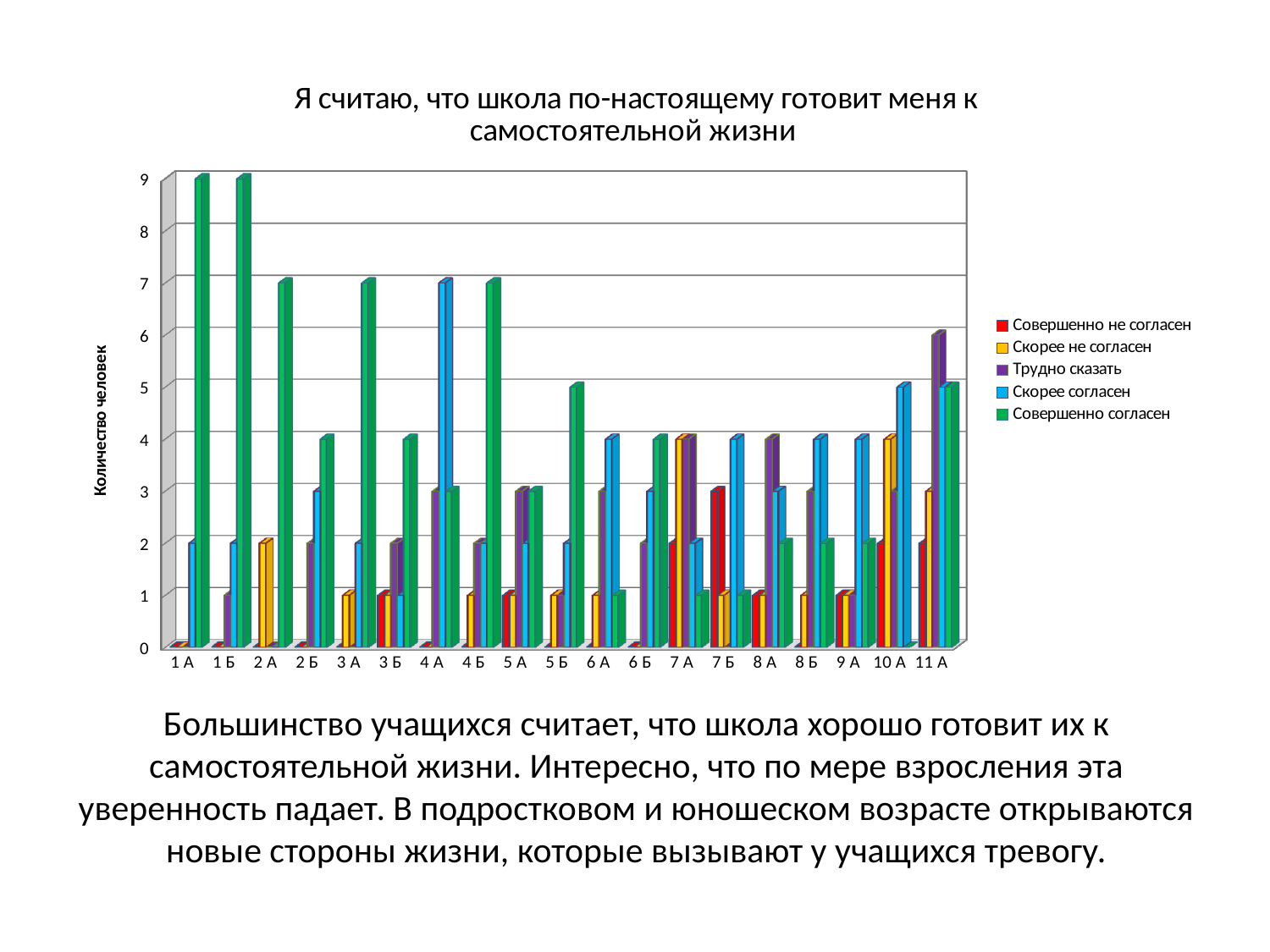
Is the value of "Трудно сказать" for class 11 А greater or less than 5? greater What kind of chart is shown on the slide? bar chart How many series does the legend list? 5 What is the title of the chart? Я считаю, что школа по-настоящему готовит меня к самостоятельной жизни Is the value of "Совершенно согласен" for class 7 А greater or less than 3? less What is the value of "Совершенно согласен" for class 2 А? 7 What is the value of "Совершенно согласен" for class 1 А? 9 What is the label of the vertical axis? Количество человек How many class categories are shown on the x axis? 19 What is the value of "Скорее согласен" for class 4 А? 7 Which is larger for class 1 Б: "Совершенно согласен" or "Скорее согласен"? Совершенно согласен Which is larger for class 10 А: "Скорее согласен" or "Совершенно согласен"? Скорее согласен